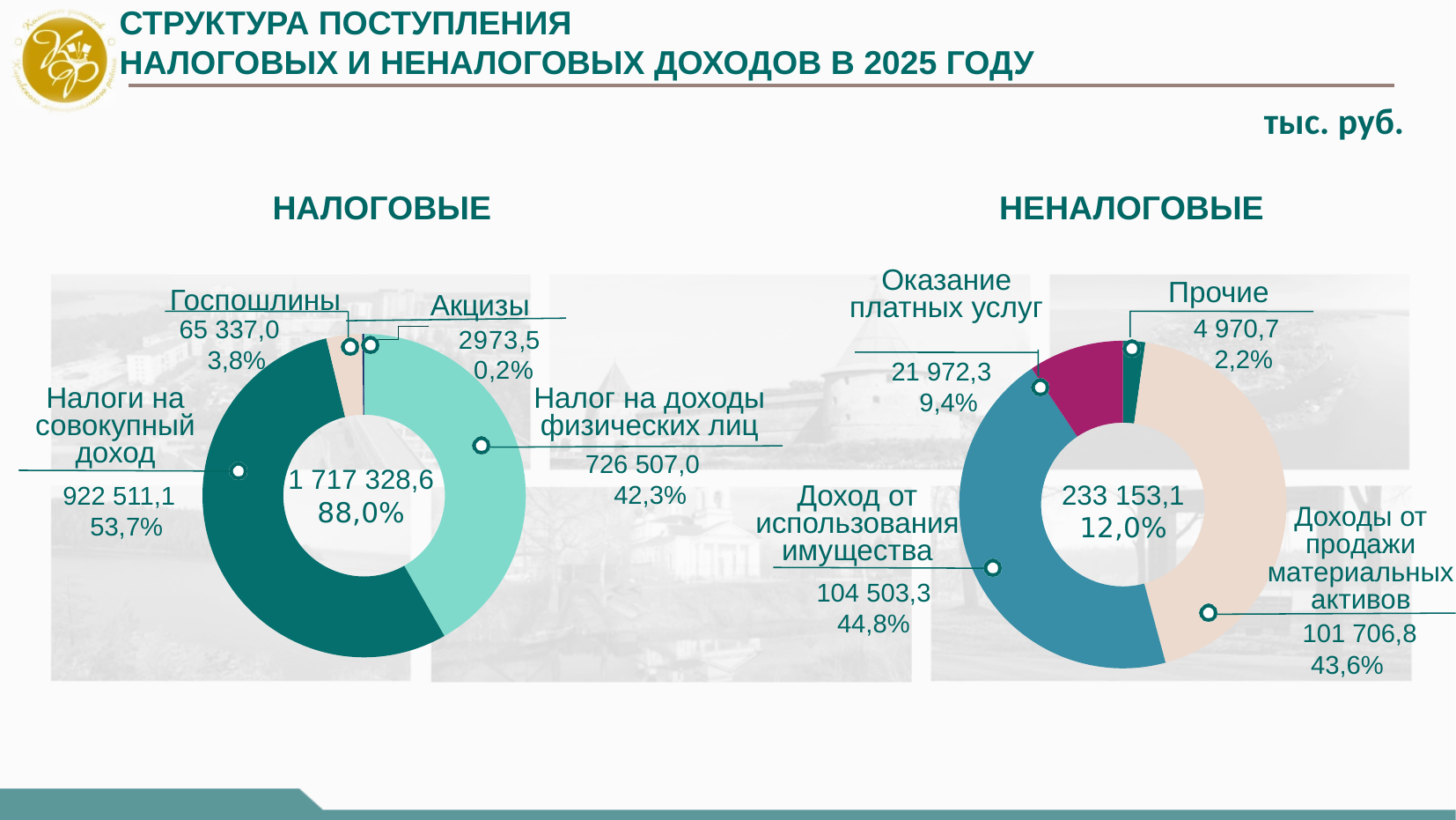
On the НЕНАЛОГОВЫЕ chart, which category has the largest share? Доход от использования имущества On the НАЛОГОВЫЕ chart, what share does Налог на доходы физических лиц have? 42,3% On the НАЛОГОВЫЕ chart, what total is shown in the centre of the donut? 1 717 328,6 What type of chart is used for НАЛОГОВЫЕ? Donut (pie) chart On the НАЛОГОВЫЕ chart, what is the value for Налоги на совокупный доход? 922 511,1 How many categories does the НЕНАЛОГОВЫЕ chart show? 4 On the НАЛОГОВЫЕ chart, what is the value for Акцизы? 2973,5 On the НЕНАЛОГОВЫЕ chart, what is the value for Оказание платных услуг? 21 972,3 On the НАЛОГОВЫЕ chart, what is the difference between Налоги на совокупный доход and Налог на доходы физических лиц? 196 004,1 On the НЕНАЛОГОВЫЕ chart, which is larger: Оказание платных услуг or Прочие? Оказание платных услуг On the НАЛОГОВЫЕ chart, which category has the smallest share? Акцизы On the НЕНАЛОГОВЫЕ chart, what share does Прочие have? 2,2%